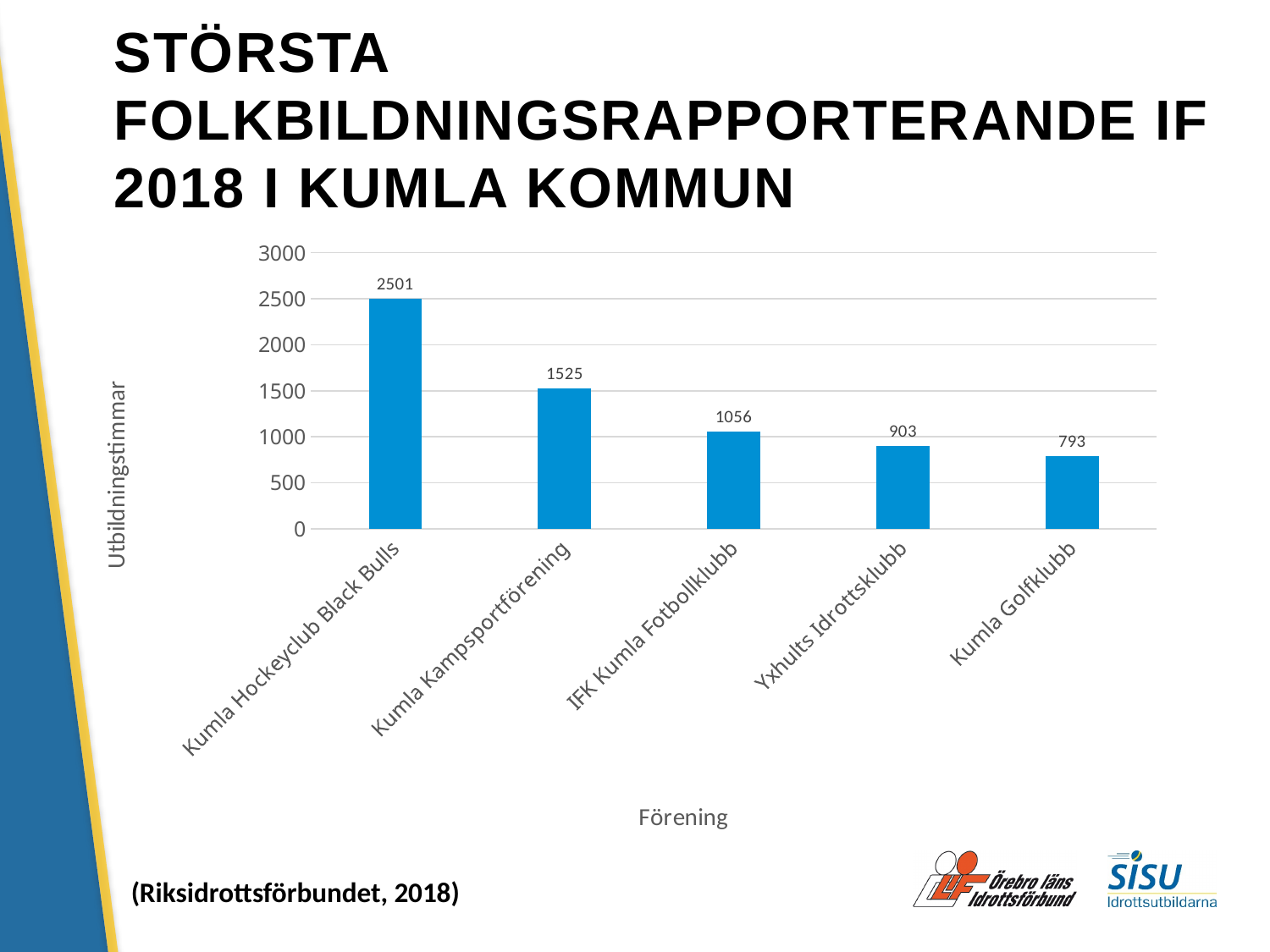
Is the value for Yxhults Idrottsklubb greater or less than 1000? less What is the value for Kumla Golfklubb? 793 What is the value for IFK Kumla Fotbollklubb? 1056 What kind of chart is shown on the slide? bar chart What is the difference between the values for Yxhults Idrottsklubb and Kumla Golfklubb? 110 How many föreningar are shown in the chart? 5 What is the value for Kumla Kampsportförening? 1525 Which has a larger value, IFK Kumla Fotbollklubb or Yxhults Idrottsklubb? IFK Kumla Fotbollklubb Which förening has the lowest number of utbildningstimmar? Kumla Golfklubb How many utbildningstimmar are shown for Kumla Hockeyclub Black Bulls? 2501 Which förening has the highest number of utbildningstimmar? Kumla Hockeyclub Black Bulls What is the difference between the values for Kumla Hockeyclub Black Bulls and Kumla Kampsportförening? 976